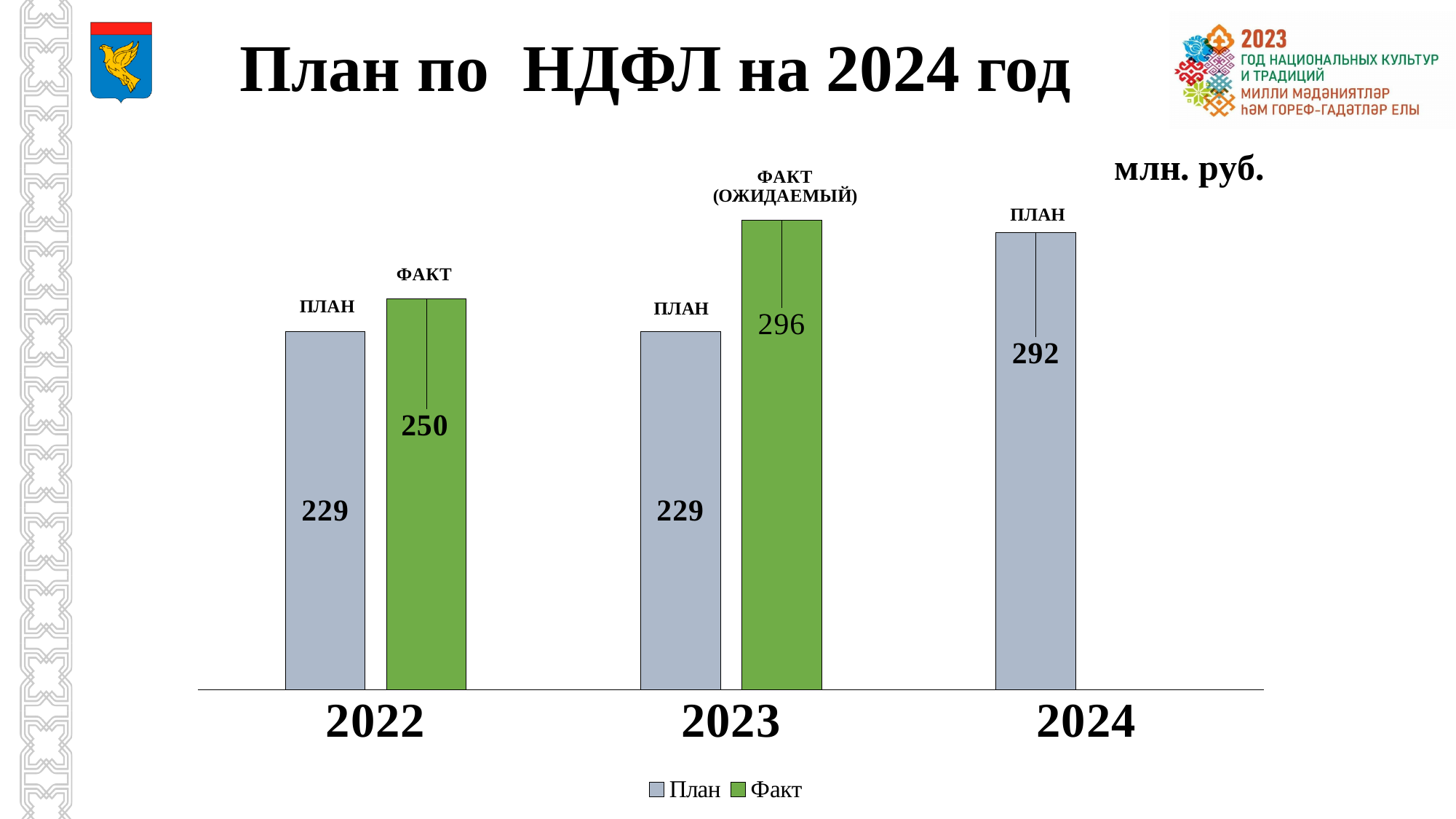
How many series does the legend list? 2 Which year has the highest Факт value? 2023 What is the difference between the Факт and План values for 2022? 21 How many years are shown on the x axis? 3 What kind of chart is shown on the slide? Bar chart What is the Факт (ожидаемый) value for 2023? 296 What is the difference between the Факт and План values for 2023? 67 Which is larger, the Факт value for 2023 or the План value for 2024? Факт value for 2023 Which year has the highest План value? 2024 What is the План value for 2024? 292 What is the Факт value for 2022? 250 What is the План value for 2022? 229